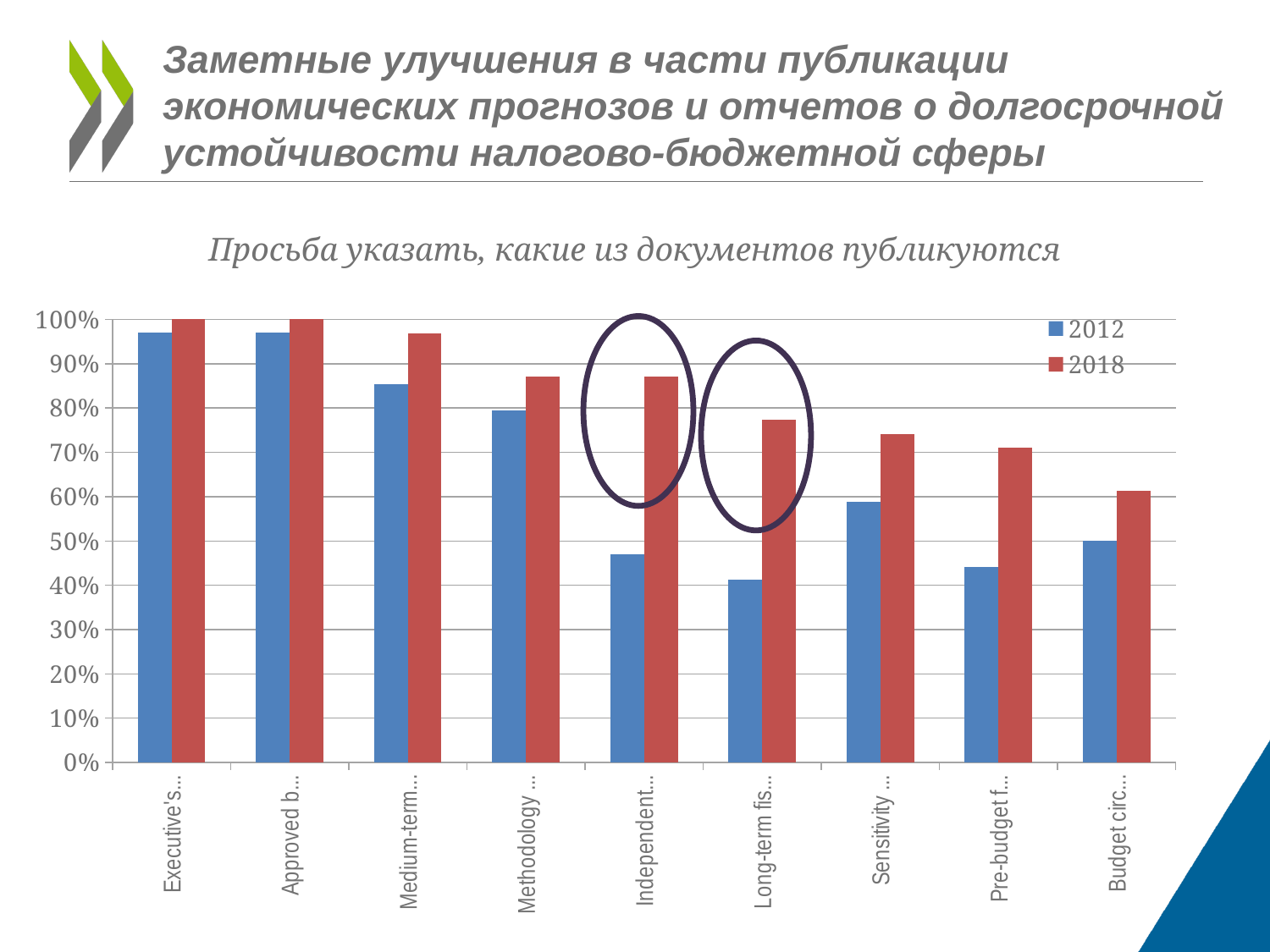
Is the 2012 value for "Sensitivity ..." greater or less than 50%? greater For the category "Pre-budget f...", which series has the larger value, 2012 or 2018? 2018 Is the 2012 value for "Long-term fis..." greater or less than 50%? less How many series does the legend list? 2 Do the 2018 values generally rise or fall from left to right along the x axis? fall What is the 2018 value for the category "Executive's..."? 100% What is the 2018 value for the category "Approved b..."? 100% What kind of chart is shown on the slide? bar chart Which category has the lowest 2018 value? Budget circ... Which colour represents the 2012 series in the chart? blue Is the 2018 value for "Independent..." greater or less than 80%? greater How many categories are shown on the x axis of the chart? 9